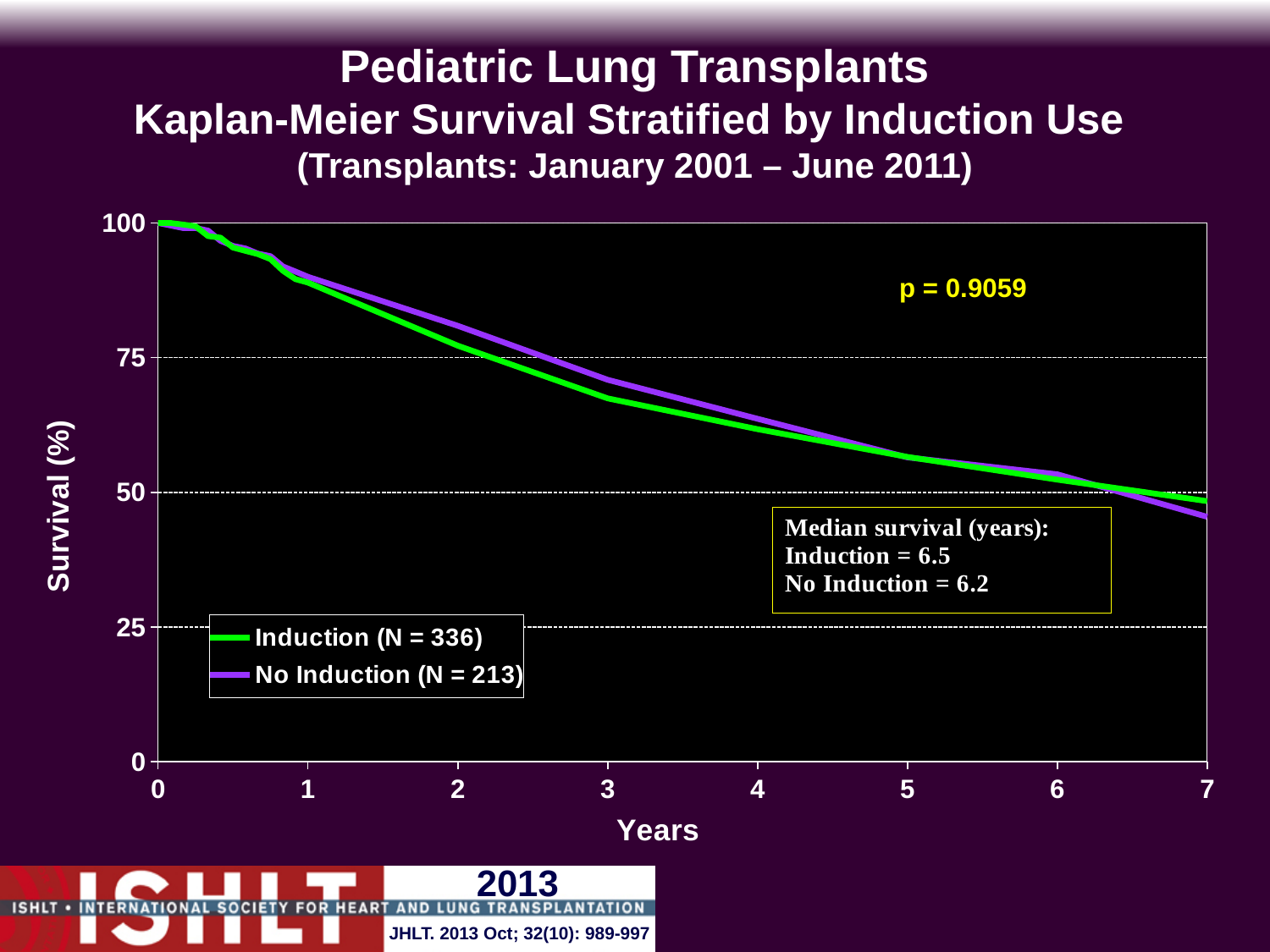
What is the median survival in years for the Induction group? 6.5 Is the survival for the Induction group at 3 years greater or less than 75? less What kind of chart is shown on the slide? line chart Is the survival for the No Induction group at 7 years greater or less than 50? less What colour is the line for the Induction group? green Which group has the longer median survival, Induction or No Induction? Induction What is the difference in median survival (years) between the Induction and No Induction groups? 0.3 How many series does the legend list? 2 What is the p-value shown on the chart? p = 0.9059 What is the median survival in years for the No Induction group? 6.2 What is the N for the Induction group in the legend? 336 Do the survival curves rise or fall as years increase? fall